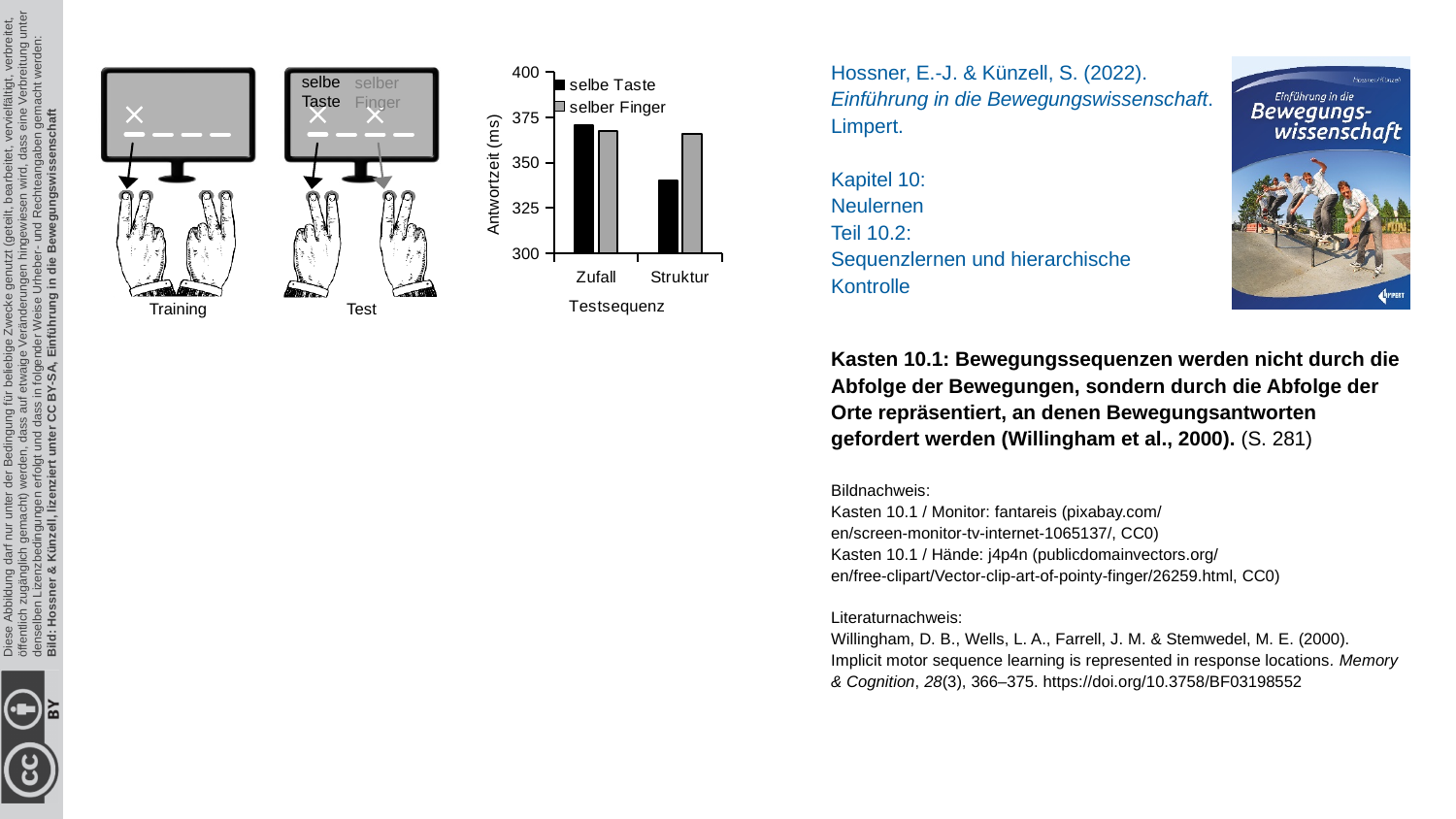
Is the value for 'selber Finger' in the Struktur condition greater or less than 350? greater Which bar in the chart is the lowest overall? selbe Taste, Struktur What is the label of the x axis of the chart? Testsequenz Does the value for 'selbe Taste' rise or fall from Zufall to Struktur? fall Is the value for 'selbe Taste' in the Struktur condition greater or less than 350? less How many series does the legend of the chart list? 2 For the 'selbe Taste' series, which category has the lowest value? Struktur How many categories are shown on the x axis of the chart? 2 What is the label of the y axis of the chart? Antwortzeit (ms) In the Struktur condition, which series has the larger value, 'selbe Taste' or 'selber Finger'? selber Finger What kind of chart is shown on the slide? bar chart Is the value for 'selbe Taste' in the Zufall condition greater or less than 350? greater